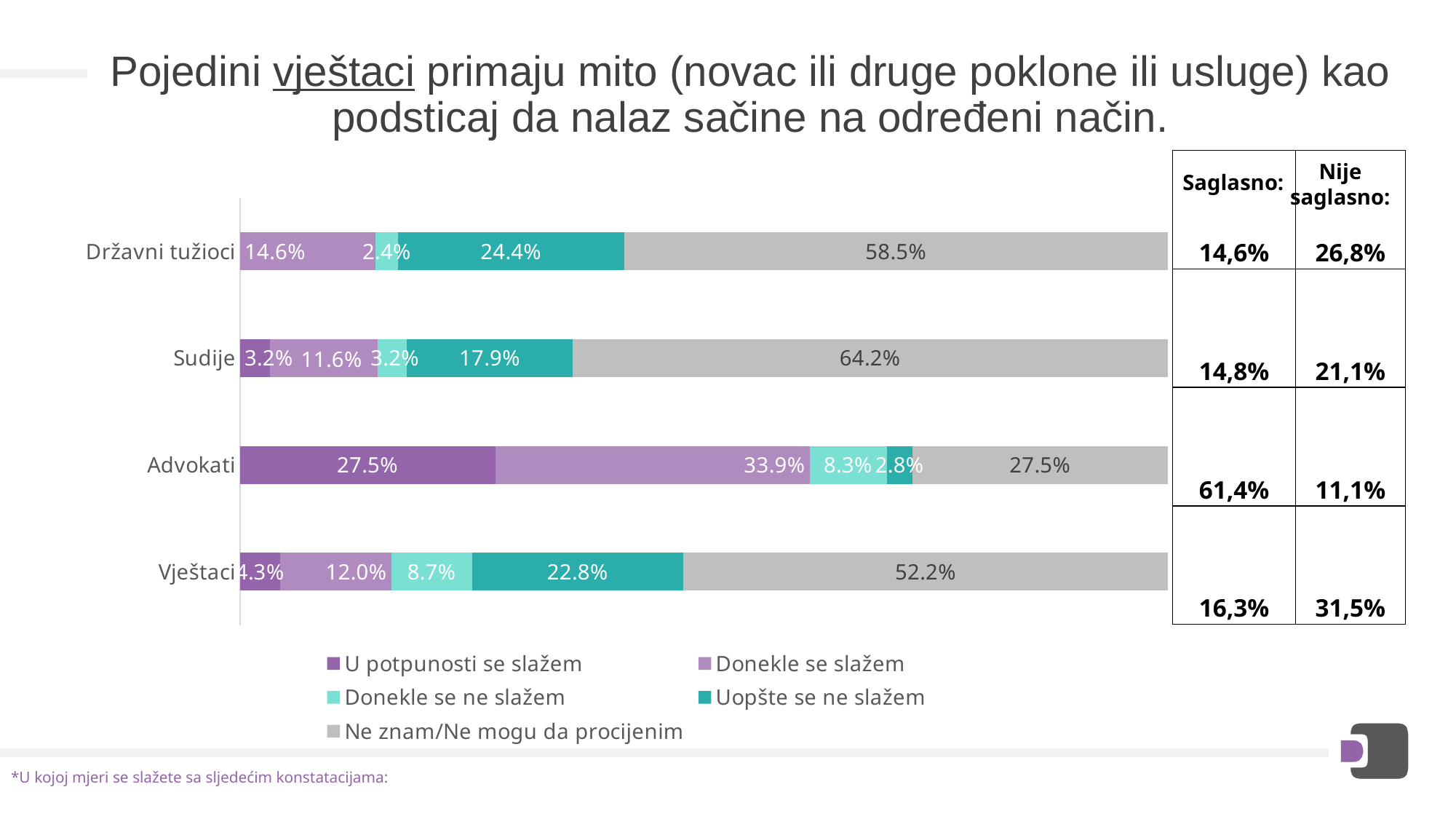
What is the value for Advokati in the 'Donekle se slažem' series? 33.9% What is the difference between the 'Ne znam/Ne mogu da procijenim' values for Sudije and Vještaci? 12.0% Which has a larger 'Uopšte se ne slažem' value, Državni tužioci or Vještaci? Državni tužioci What is the value for Advokati in the 'U potpunosti se slažem' series? 27.5% What is the value for Sudije in the 'Ne znam/Ne mogu da procijenim' series? 64.2% What kind of chart is shown on the slide? Stacked bar chart How many categories are shown on the chart? 4 Which category has the lowest value in the 'Ne znam/Ne mogu da procijenim' series? Advokati How many series does the legend list? 5 What is the value for Vještaci in the 'Uopšte se ne slažem' series? 22.8% Which category has the highest value in the 'Ne znam/Ne mogu da procijenim' series? Sudije For Advokati, what is the difference between the 'Donekle se slažem' and 'U potpunosti se slažem' values? 6.4%